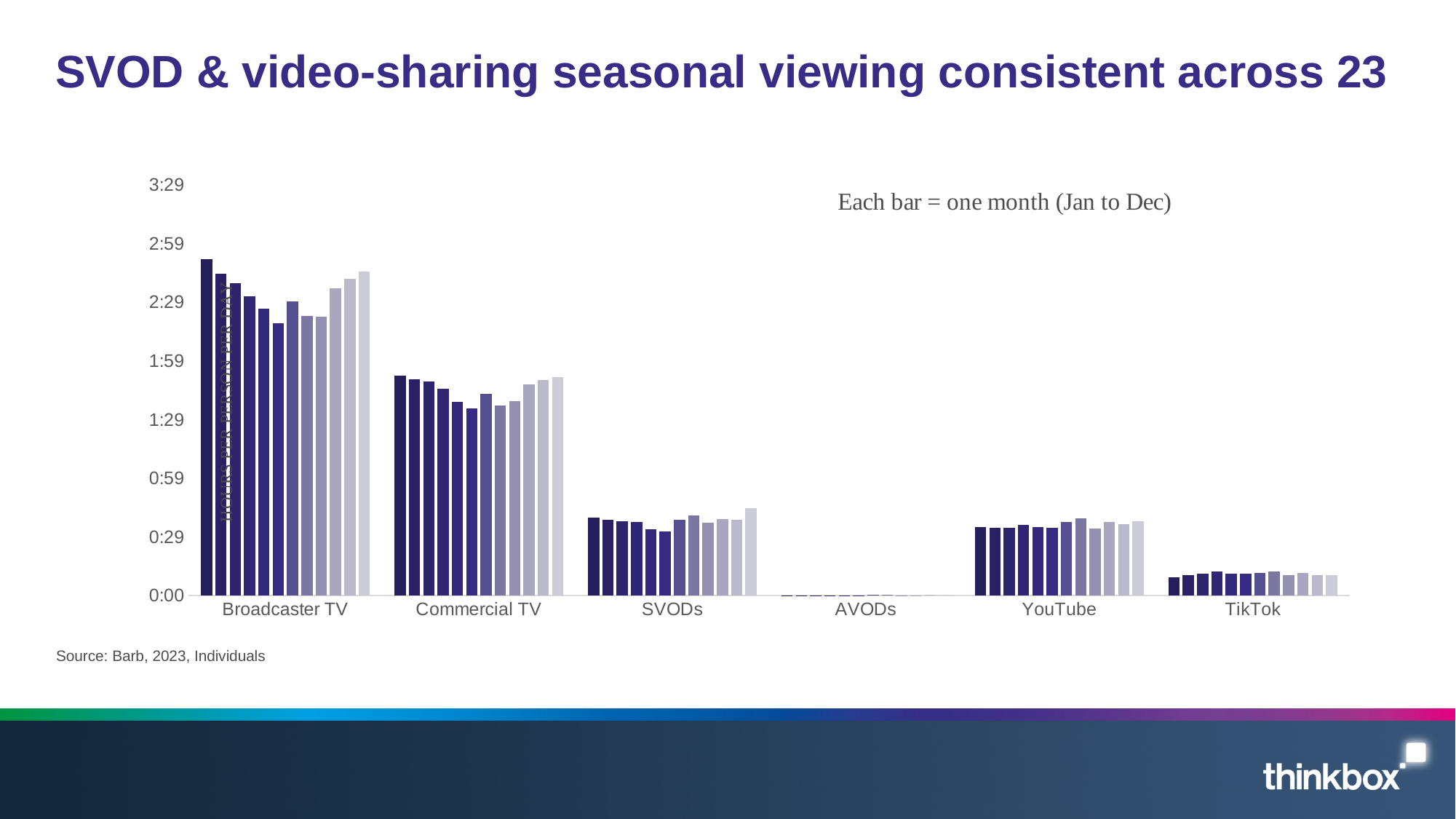
Is the December value for SVODs greater or less than 0:59? less Is the January value for Broadcaster TV greater or less than 2:29? greater Is the January value for TikTok greater or less than 0:29? less Which category has higher bars, Commercial TV or SVODs? Commercial TV What is the source cited for the chart? Barb, 2023, Individuals According to the note on the chart, what does each bar represent? One month (Jan to Dec) What kind of chart is shown on the slide? Bar chart Which category has higher bars, YouTube or TikTok? YouTube Which category has the lowest viewing values in the chart? AVODs Which category has the highest viewing values in the chart? Broadcaster TV How many categories are shown along the x axis of the chart? 6